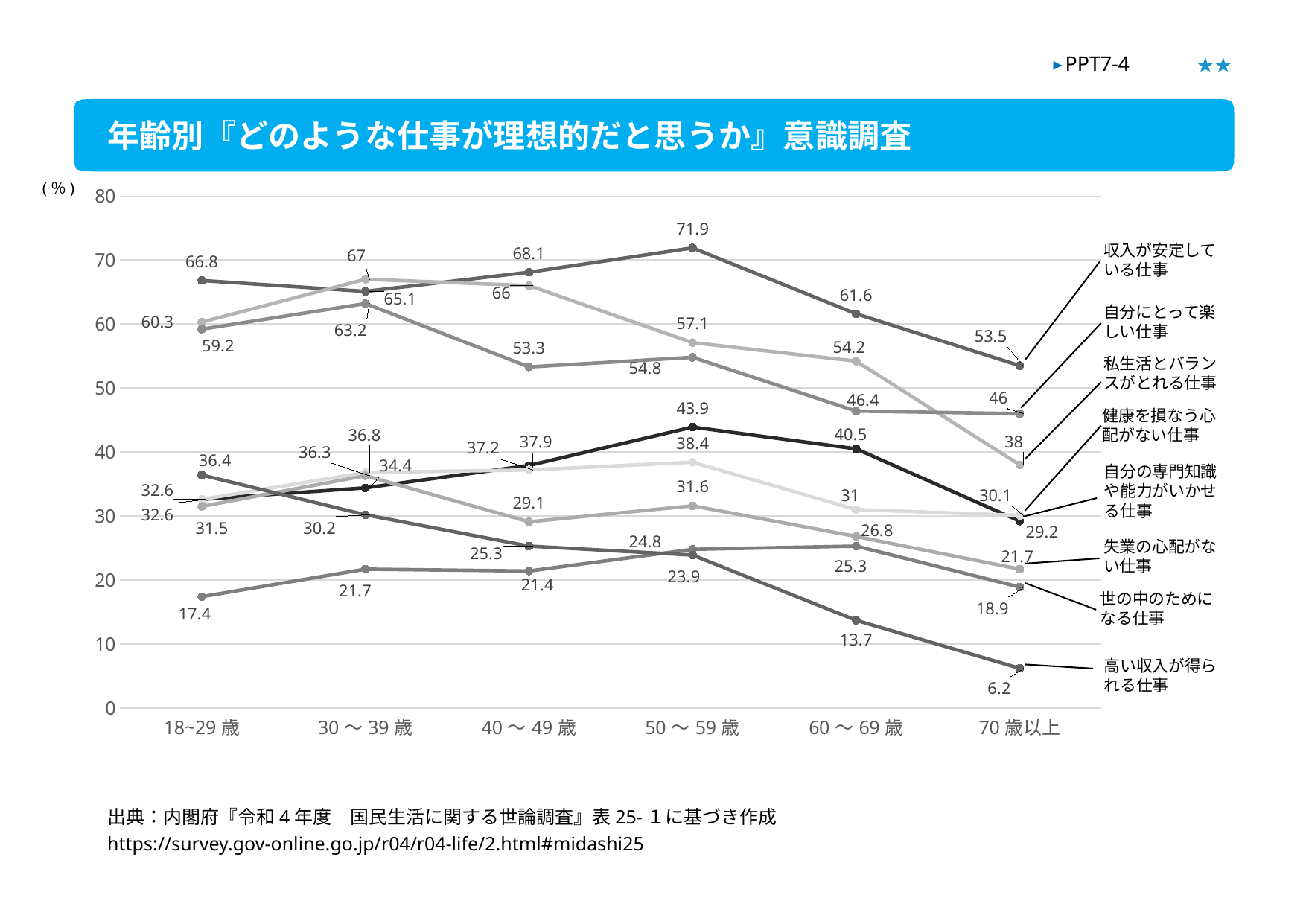
In the 70歳以上 group, what is the difference between 収入が安定している仕事 and 自分にとって楽しい仕事? 7.5 What is the highest value plotted on the chart, and for which age group? 71.9, 50〜59歳 How many age categories are shown on the x axis? 6 What is the value for 収入が安定している仕事 in the 70歳以上 group? 53.5 In the 70歳以上 group, which is larger: 自分にとって楽しい仕事 or 私生活とバランスがとれる仕事? 自分にとって楽しい仕事 What is the value for 高い収入が得られる仕事 in the 60〜69歳 group? 13.7 What kind of chart is shown on the slide? line chart What is the value for 世の中のためになる仕事 in the 18~29歳 group? 17.4 What is the value for 高い収入が得られる仕事 in the 70歳以上 group? 6.2 Does the line for 高い収入が得られる仕事 rise or fall from the 18~29歳 group to the 70歳以上 group? fall Which job type has the lowest value in the 70歳以上 group? 高い収入が得られる仕事 How many series (job types) are plotted on the chart? 8